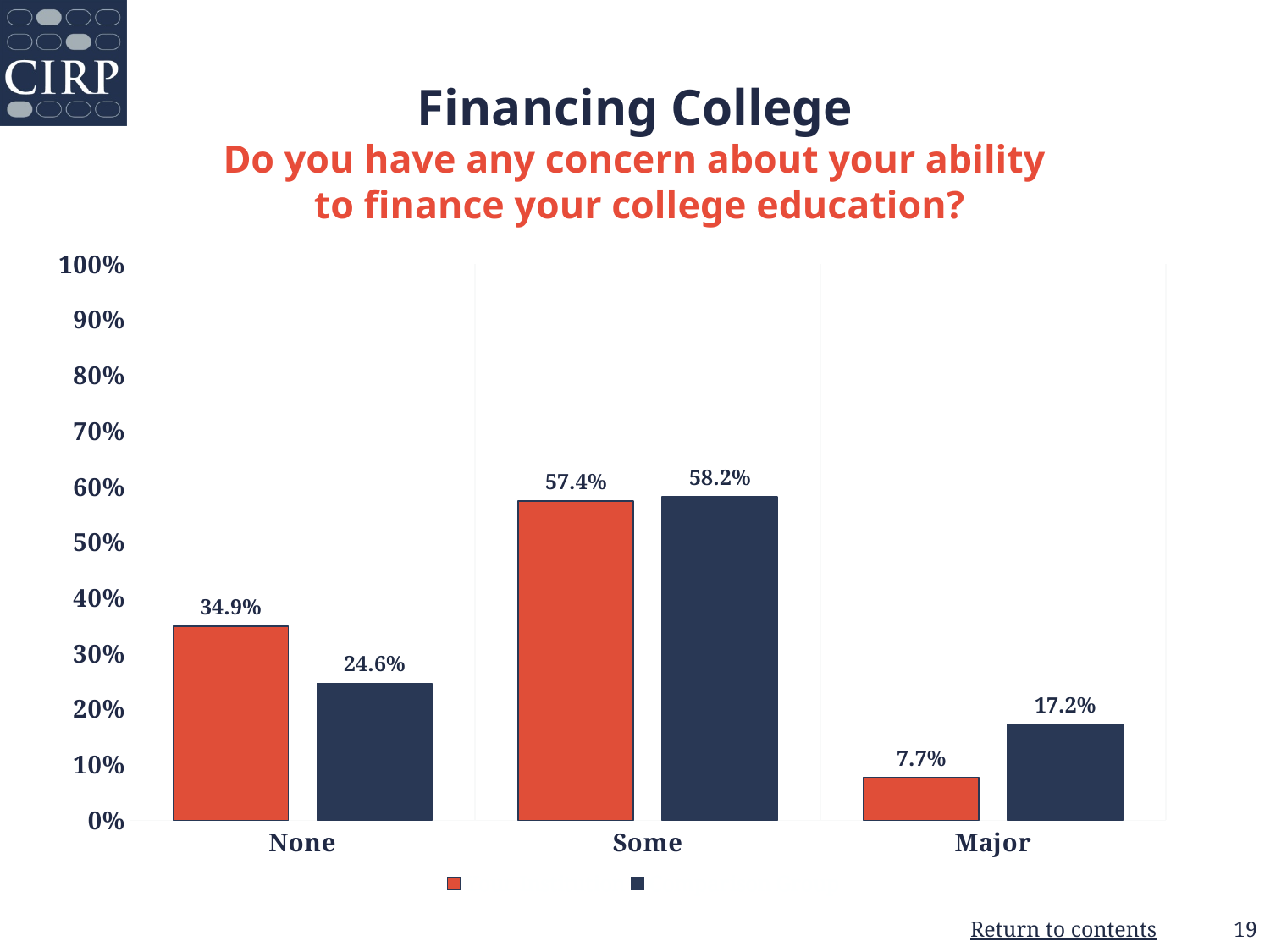
What kind of chart is shown on the slide? bar chart What is the value of the orange bar for the "None" category? 34.9% For the "Major" category, which bar is larger, the orange one or the dark blue one? the dark blue one What is the difference between the orange and dark blue bars for the "None" category? 10.3% What is the difference between the dark blue and orange bars for the "Major" category? 9.5% How many series does the legend list? 2 Which category has the highest value for the dark blue series? Some What is the value of the dark blue bar for the "None" category? 24.6% What is the value of the orange bar for the "Some" category? 57.4% What is the value of the dark blue bar for the "Major" category? 17.2% Which category has the lowest value for the orange series? Major How many categories are shown on the x axis? 3